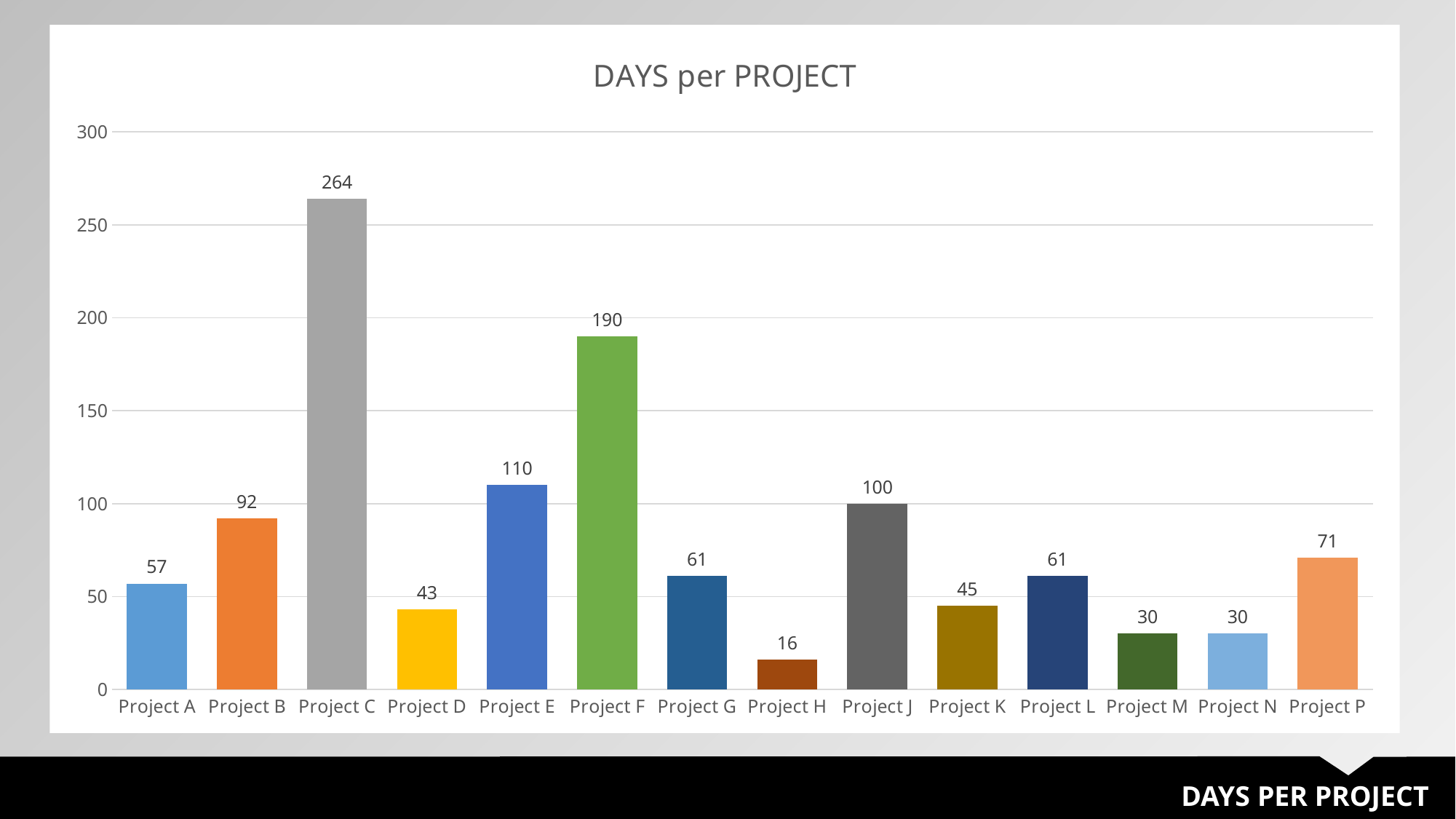
What kind of chart is shown on the slide? Bar chart What is the title of the chart? DAYS per PROJECT What is the value for Project C? 264 How many projects are shown on the chart? 14 What is the value for Project P? 71 Which project has the lowest number of days? Project H Which project has the highest number of days? Project C What is the difference between the values for Project E and Project J? 10 Which is larger, the value for Project B or the value for Project K? Project B Is the value for Project F greater or less than 150? greater What is the value for Project H? 16 What is the difference between the values for Project C and Project F? 74